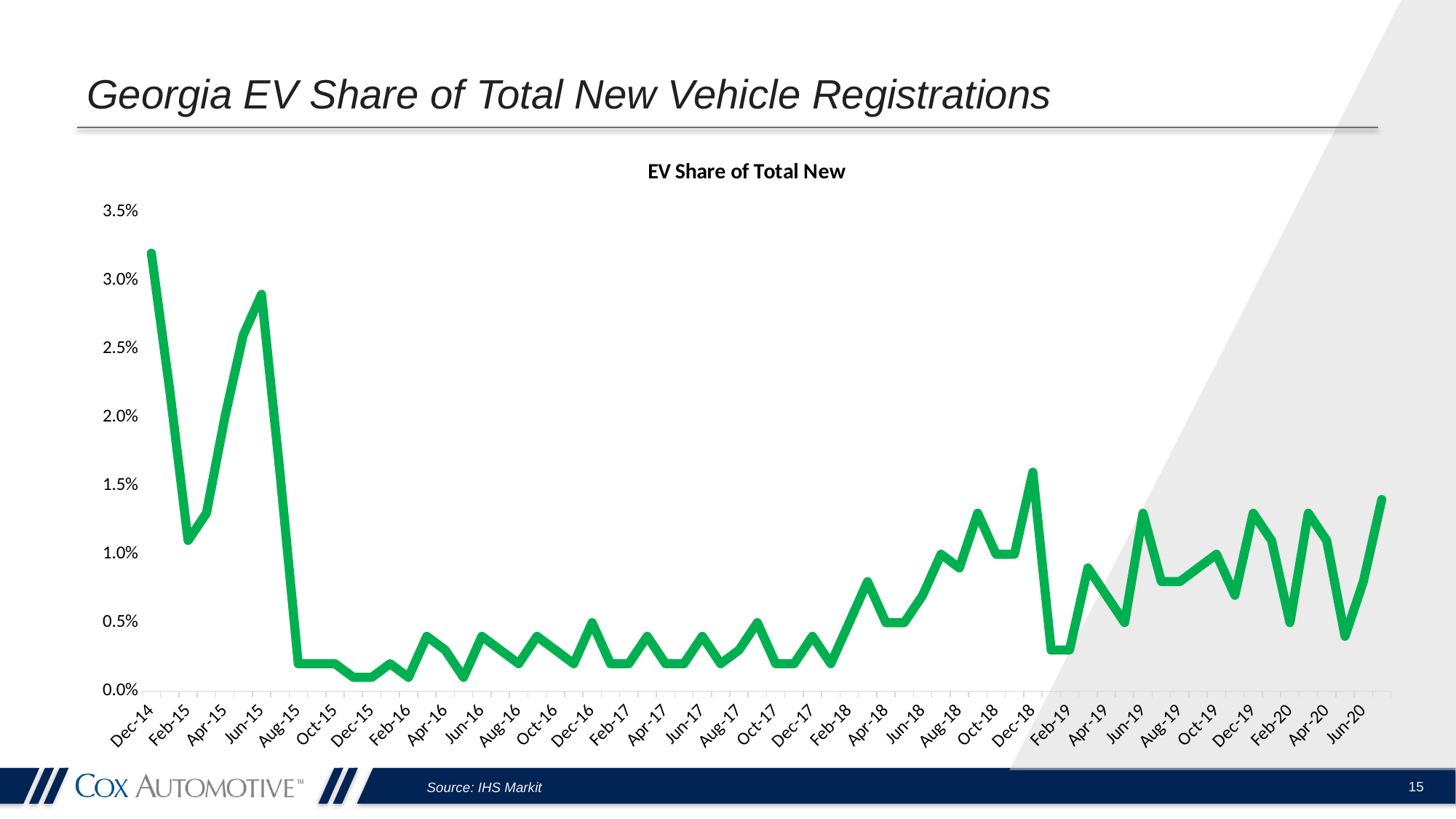
What source is cited for the chart data? IHS Markit Is the value for Dec-14 greater or less than 3.0%? greater Is the value for Jun-15 greater or less than 2.5%? greater Which is larger, the EV share in Dec-14 or in Jun-15? Dec-14 Does the EV share generally rise or fall between Dec-17 and Dec-18? rise What kind of chart is shown on the slide? line chart Which month has the highest EV share on the chart? Dec-14 Is the value for Jun-20 greater or less than 1.0%? less What is the title of the chart? EV Share of Total New